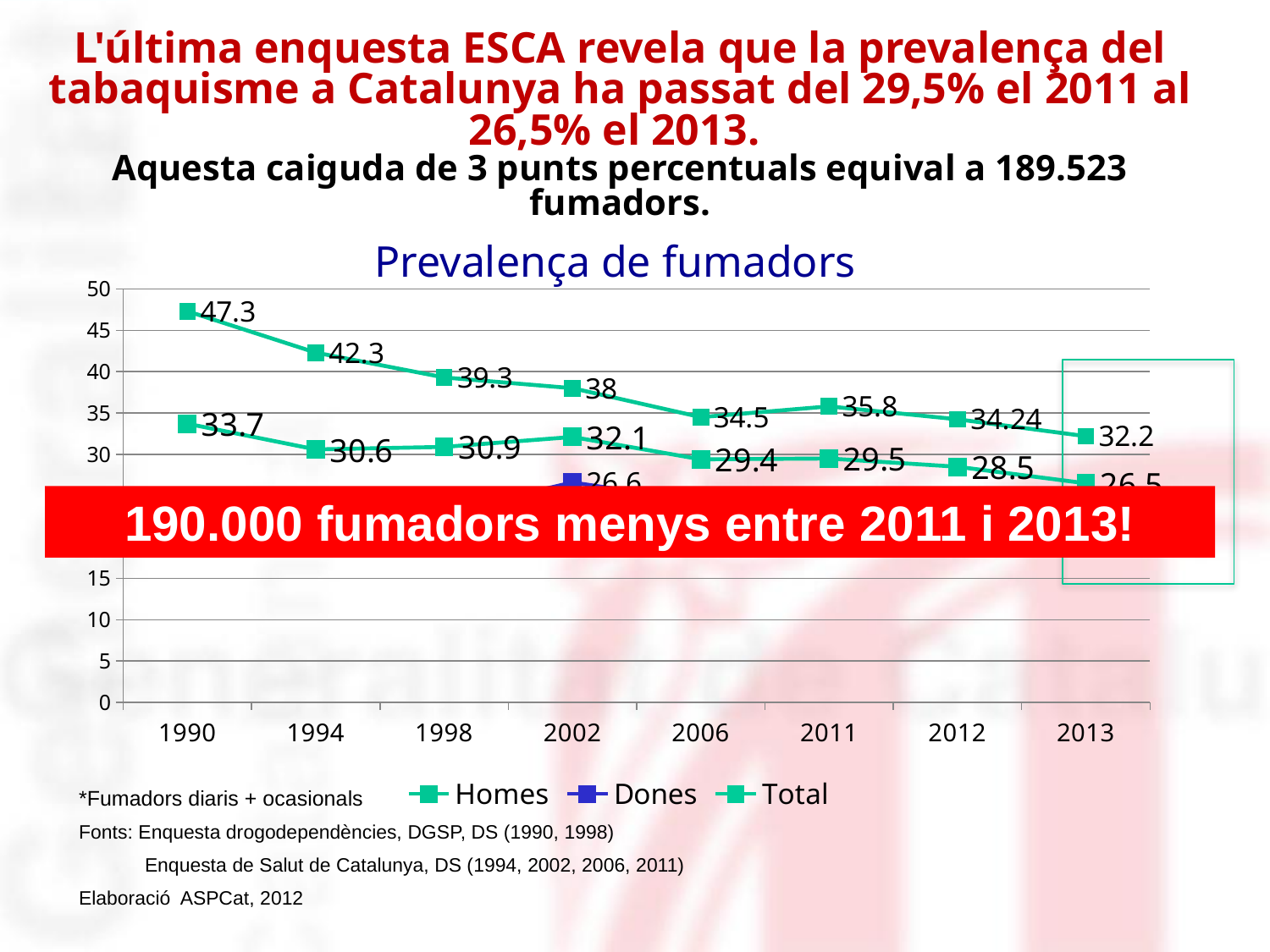
In which year is the Total value lowest? 2013 What is the value for Total in 2013? 26.5 What is the value for Homes in 2012? 34.24 Does the Homes series generally rise or fall from 1990 to 2013? fall What is the value for Homes in 1990? 47.3 How many years are shown on the x axis of the chart? 8 What is the value for Total in 2011? 29.5 What is the title of the chart? Prevalença de fumadors What is the difference between the Total value in 2011 and in 2013? 3 In which year is the Homes value highest? 1990 What type of chart is shown on the slide? line chart How many series does the chart legend list? 3